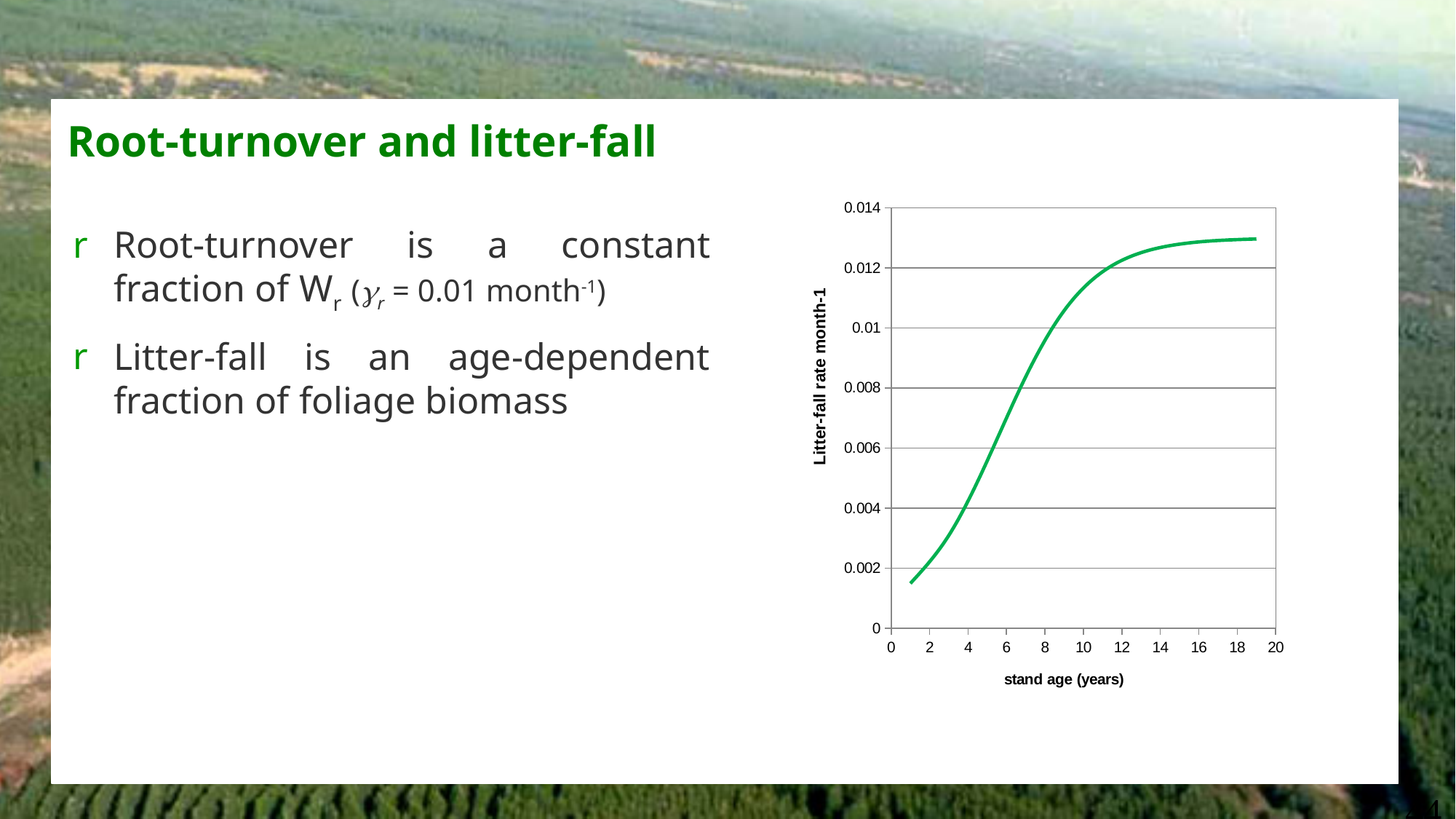
Is the litter-fall rate at a stand age of 2 years greater or less than 0.004? less Is the litter-fall rate at a stand age of 18 years greater or less than 0.014? less Does the litter-fall rate rise or fall as stand age increases? rises Is the litter-fall rate at a stand age of 16 years greater or less than 0.012? greater What is the label of the horizontal axis of the chart? stand age (years) Is the litter-fall rate higher at a stand age of 14 years or at a stand age of 4 years? 14 years What kind of chart is shown on the slide? line chart What is the label of the vertical axis of the chart? Litter-fall rate month-1